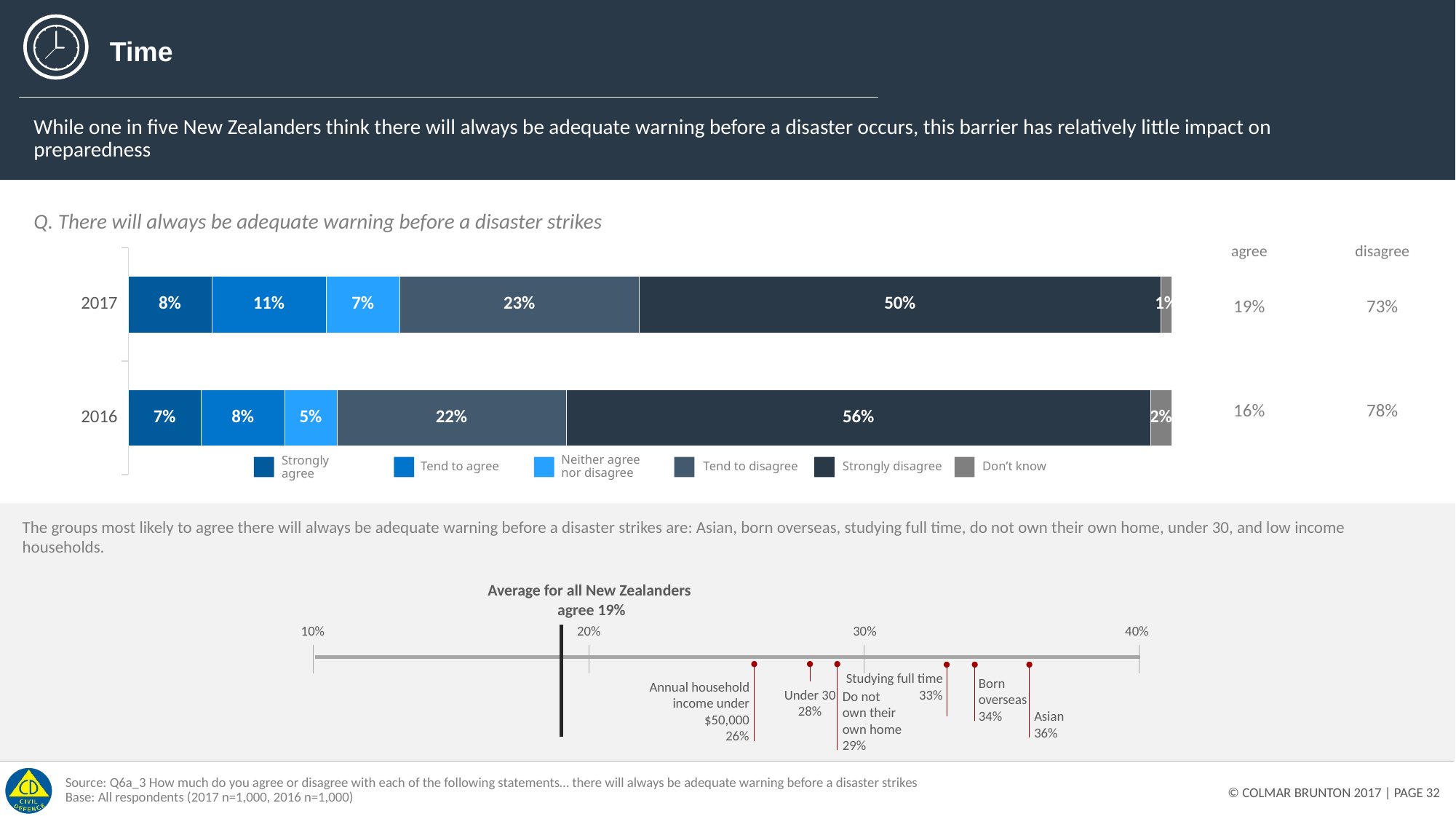
How many years are shown as bars in the stacked bar chart? 2 In the lower chart of groups most likely to agree, which group has the lowest value? Annual household income under $50,000 In the stacked bar chart, what percentage answered 'Don't know' in 2016? 2% In the stacked bar chart, what percentage of respondents tended to agree in 2016? 8% How many series does the legend of the stacked bar chart list? 6 In the stacked bar chart, what is the difference between the 'Strongly disagree' values for 2016 and 2017? 6 percentage points In the stacked bar chart, what percentage of respondents strongly disagreed in 2017? 50% In the stacked bar chart, which year had the larger 'Tend to disagree' value, 2017 or 2016? 2017 In the lower chart of groups most likely to agree, what is the value for Asian? 36% What kind of chart is the chart showing the 2017 and 2016 responses? Stacked bar chart In the lower chart of groups most likely to agree, which group has the highest value? Asian In the lower chart, what is the average agreement for all New Zealanders? 19%